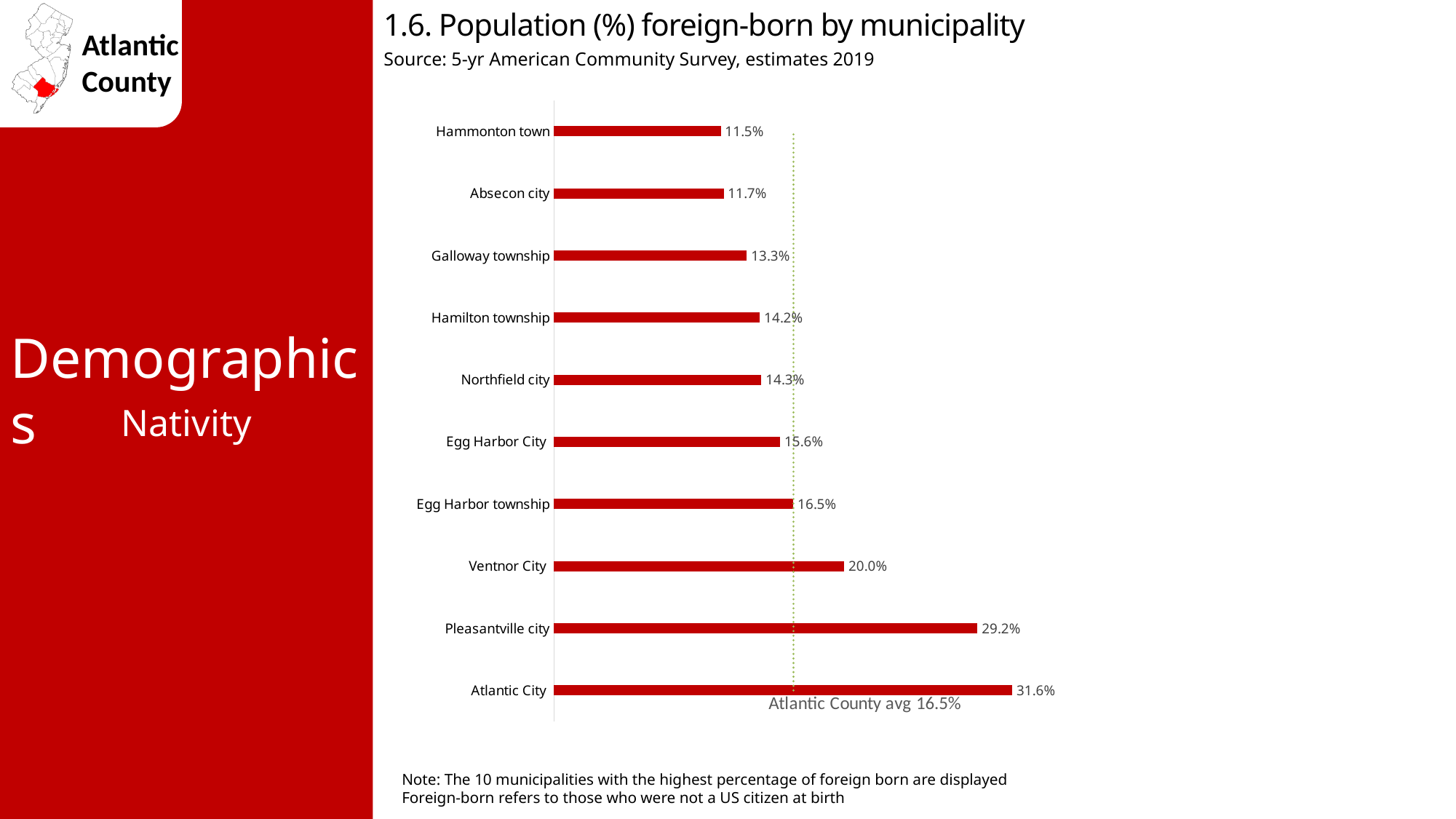
Which has a higher foreign-born percentage, Hamilton township or Absecon city? Hamilton township Which has a higher foreign-born percentage, Pleasantville city or Ventnor City? Pleasantville city What is the foreign-born population percentage for Ventnor City? 20.0% What is the difference in foreign-born percentage between Ventnor City and Egg Harbor City? 4.4% What is the foreign-born population percentage for Atlantic City? 31.6% What is the foreign-born population percentage for Galloway township? 13.3% What is the difference in foreign-born percentage between Atlantic City and Pleasantville city? 2.4% Which municipality has the highest percentage of foreign-born population? Atlantic City What is the Atlantic County average foreign-born percentage marked by the dotted line? 16.5% How many municipalities are shown on the chart? 10 What type of chart is used to show the foreign-born population by municipality? Bar chart Which municipality has the lowest percentage of foreign-born population on the chart? Hammonton town